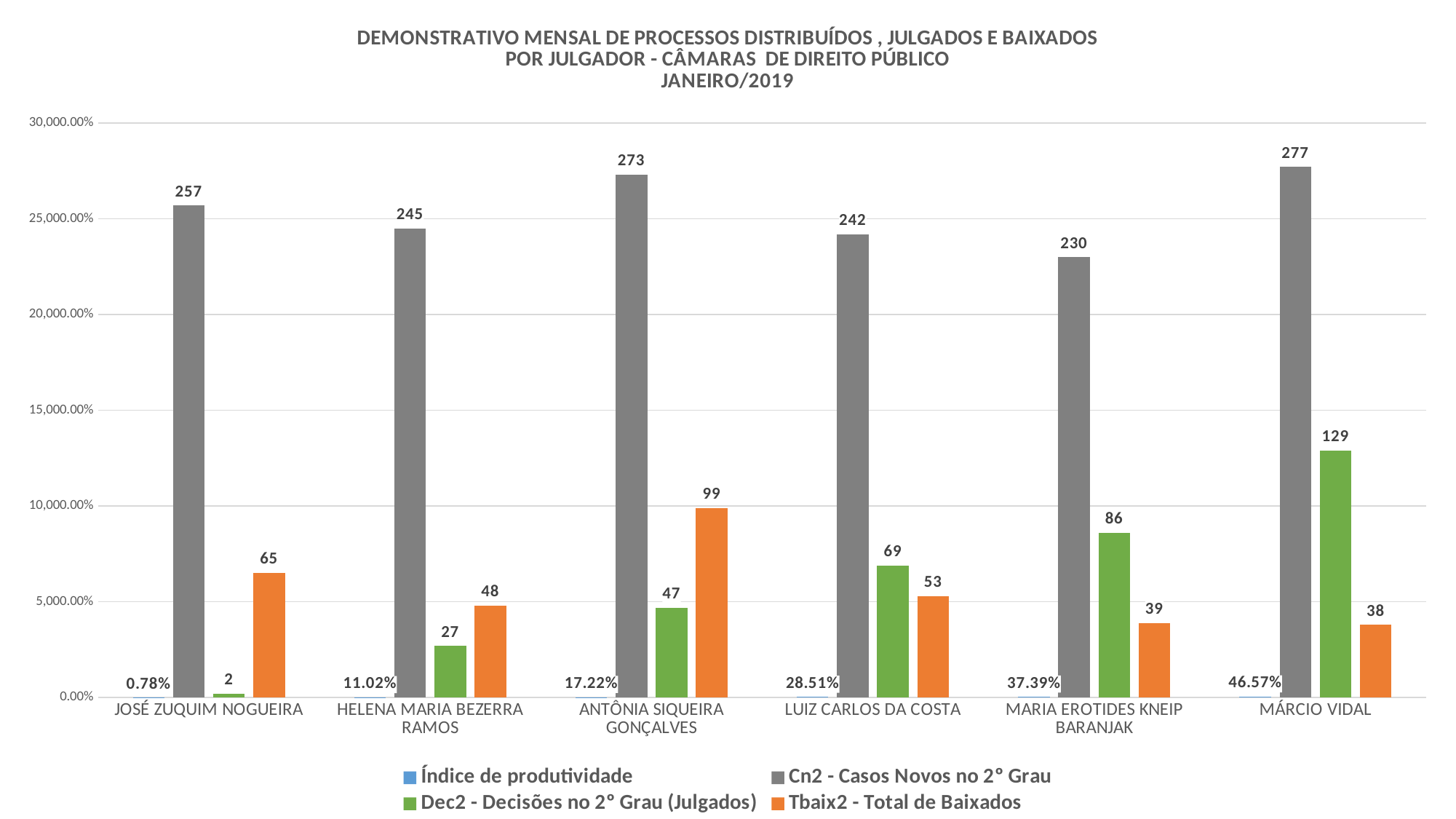
How many judges are shown on the x axis? 6 Which judge has the lowest Cn2 - Casos Novos no 2° Grau value? MARIA EROTIDES KNEIP BARANJAK What is the Índice de produtividade for LUIZ CARLOS DA COSTA? 28.51% How many series does the legend list? 4 What is the Tbaix2 - Total de Baixados value for ANTÔNIA SIQUEIRA GONÇALVES? 99 Which colour represents Tbaix2 - Total de Baixados in the legend? Orange Which judge has the highest Dec2 - Decisões no 2° Grau (Julgados) value? MÁRCIO VIDAL What kind of chart is shown on the slide? Bar chart What is the Cn2 - Casos Novos no 2° Grau value for MÁRCIO VIDAL? 277 Which is larger, the Tbaix2 value for JOSÉ ZUQUIM NOGUEIRA or for LUIZ CARLOS DA COSTA? JOSÉ ZUQUIM NOGUEIRA Do the Índice de produtividade values rise or fall from left to right along the x axis? Rise What is the difference between the Cn2 values for MÁRCIO VIDAL and JOSÉ ZUQUIM NOGUEIRA? 20